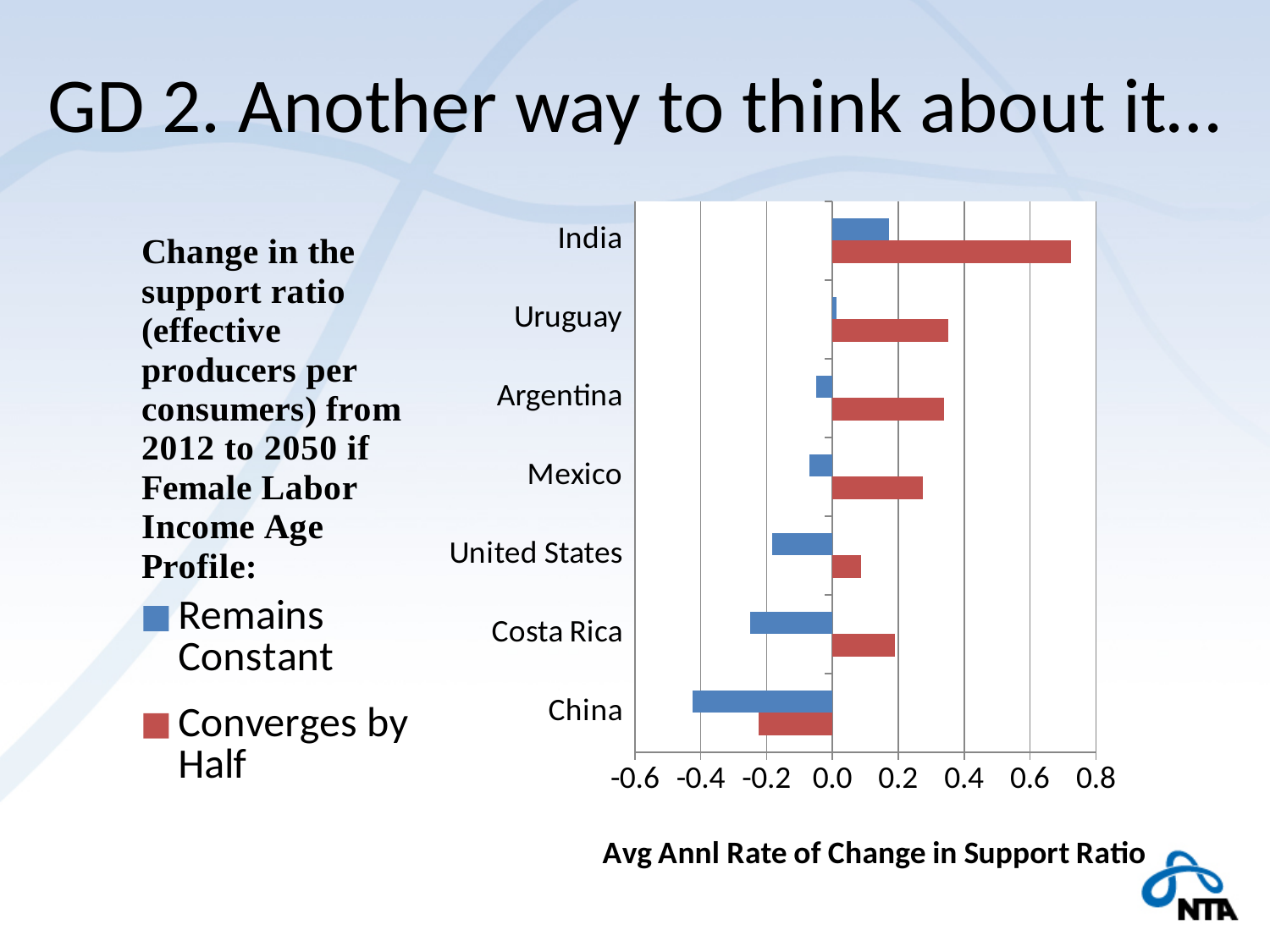
Which country has the lowest value for the Remains Constant series? China Is the Converges by Half value for the United States greater or less than 0.2? less Which country has the highest value for the Converges by Half series? India How many countries are shown on the chart? 7 Which country has a larger Converges by Half value: Mexico or the United States? Mexico How many series does the legend list? 2 Is the Remains Constant value for China greater or less than -0.4? less Is the Converges by Half value for India greater or less than 0.6? greater What is the title of the horizontal axis? Avg Annl Rate of Change in Support Ratio For Costa Rica, which series has the larger value: Remains Constant or Converges by Half? Converges by Half What kind of chart is shown on the slide? bar chart Which country has the lowest value for the Converges by Half series? China